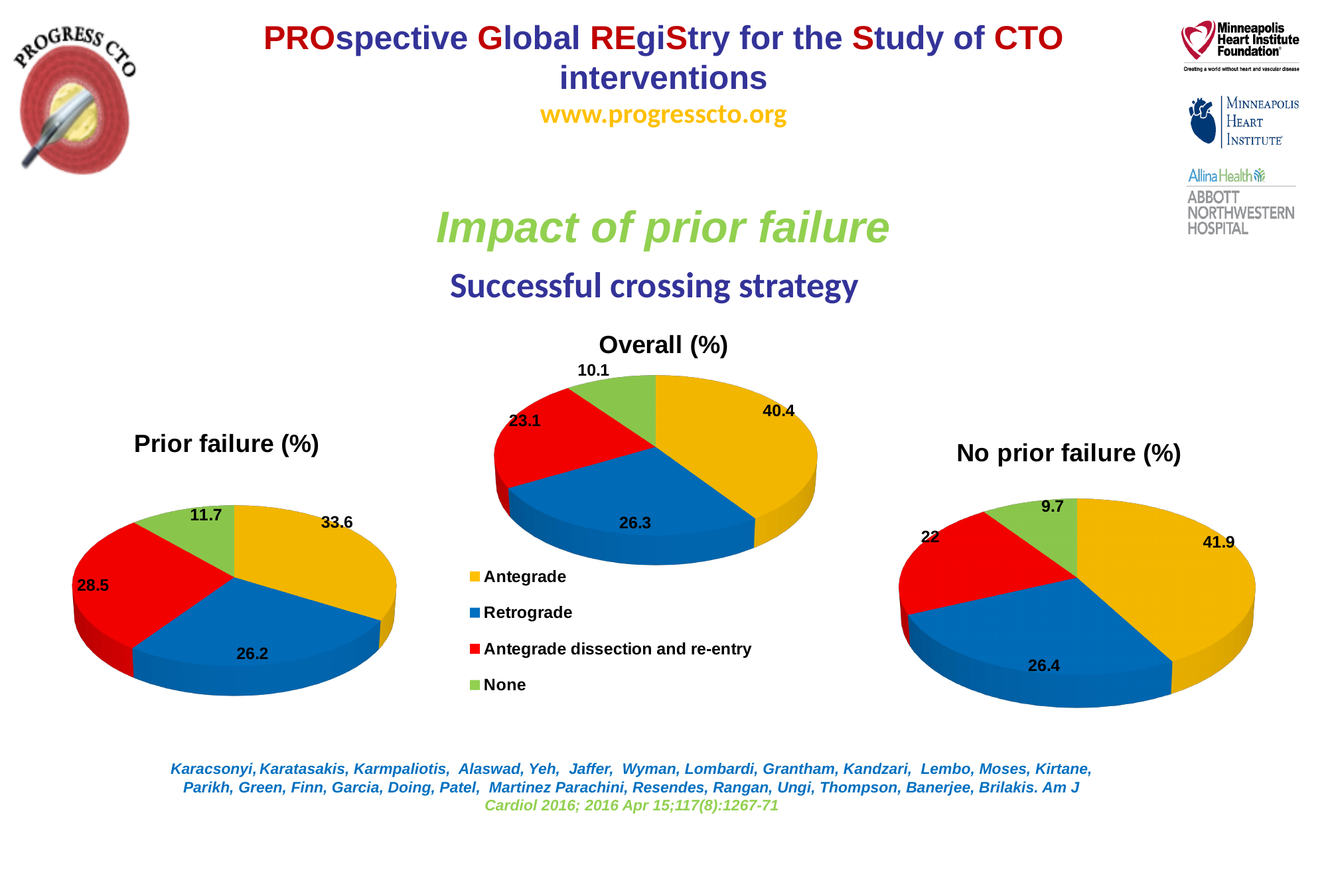
What is the difference between the Antegrade values in the No prior failure (%) chart and the Prior failure (%) chart? 8.3 In the Prior failure (%) pie chart, what is the value for Antegrade dissection and re-entry? 28.5 How many entries does the shared legend list? 4 What type of chart is the Overall (%) chart? Pie chart How many slices does the Prior failure (%) pie chart have? 4 In the No prior failure (%) pie chart, what is the value for Retrograde? 26.4 In the Prior failure (%) pie chart, which category has the largest slice? Antegrade In the Overall (%) pie chart, which category has the smallest slice? None In the No prior failure (%) pie chart, what is the value for None? 9.7 In the Overall (%) pie chart, what is the value for Antegrade? 40.4 Which colour represents Antegrade dissection and re-entry in the legend? Red In the Overall (%) pie chart, which is larger: Retrograde or Antegrade dissection and re-entry? Retrograde